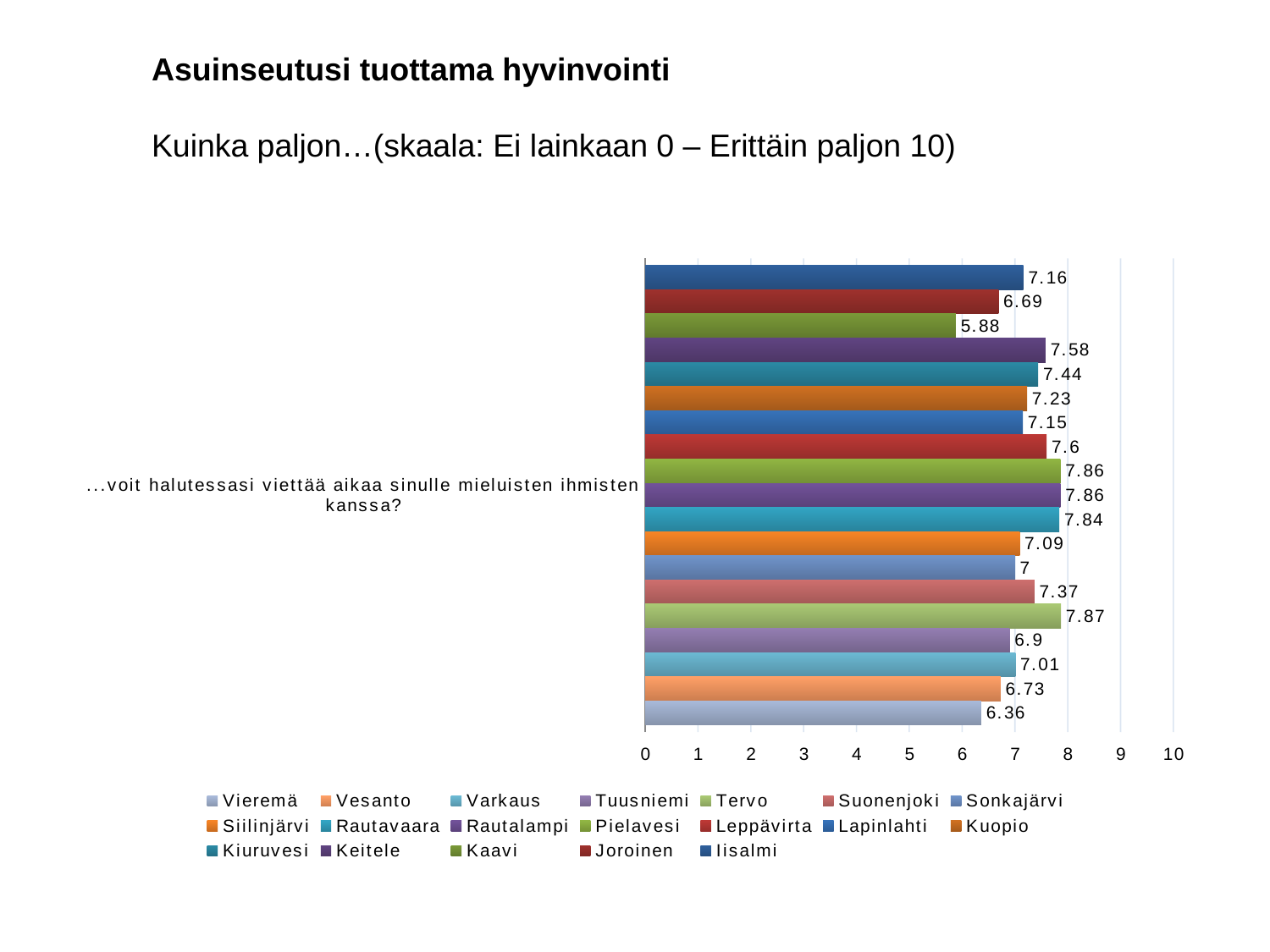
What is the value for Kaavi? 5.88 How many categories are plotted on the y axis? 1 What is the difference between the values for Iisalmi and Kaavi? 1.28 How many series does the legend list? 19 What is the highest value shown on the chart? 7.87 Is the value for Kaavi greater or less than 6? less What is the value for Vieremä? 6.36 Which municipality has the lowest value? Kaavi What kind of chart is shown on the slide? bar chart What is the maximum value shown on the x axis? 10 Which is larger, the value for Joroinen or the value for Kaavi? Joroinen What is the value for Iisalmi? 7.16